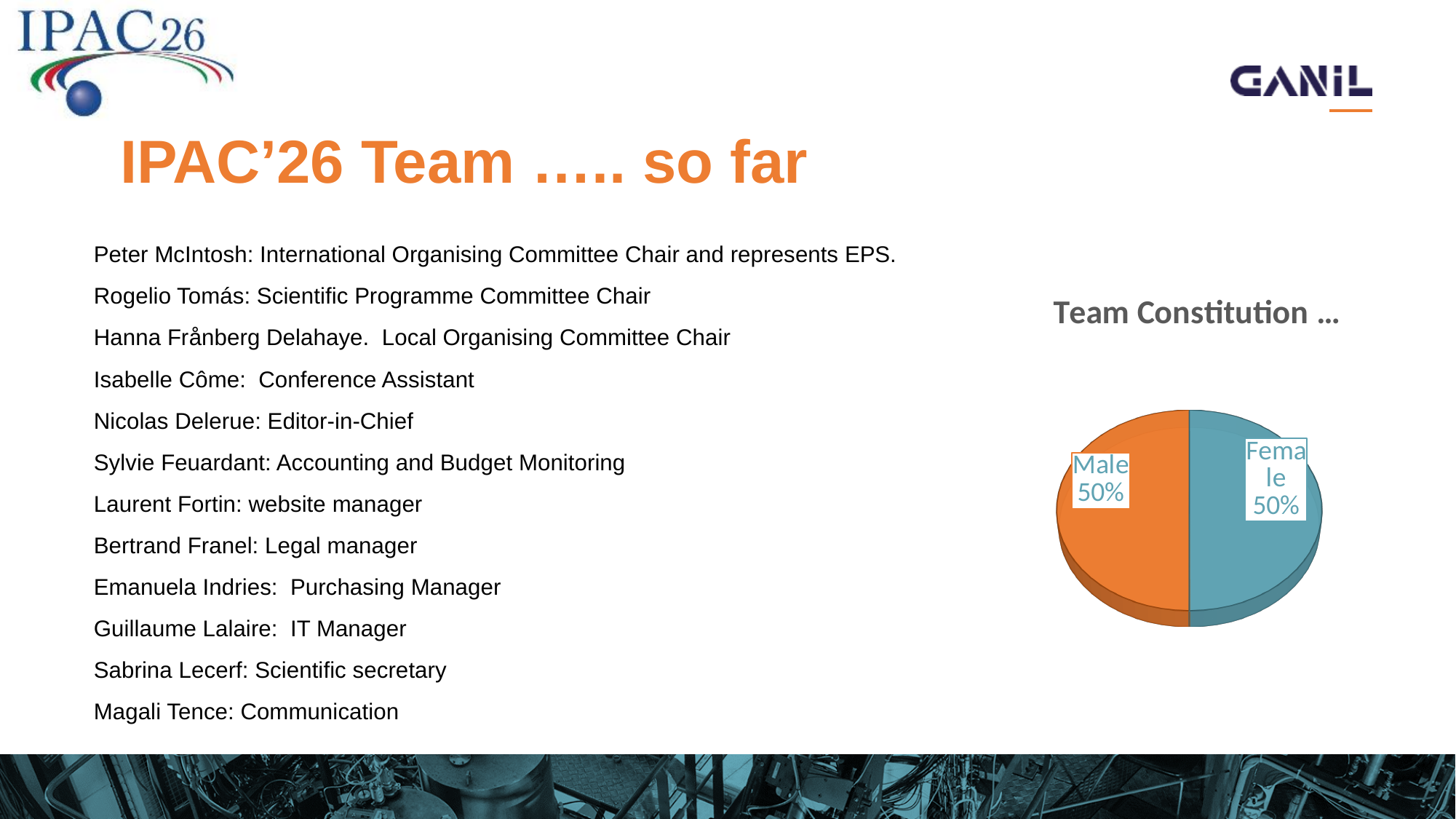
What kind of chart is shown on the slide? pie chart What is the title of the chart? Team Constitution … What share of the pie does the Female slice represent? 50% What is the difference between the Male and Female shares? 0% What share of the pie does the Male slice represent? 50% How many slices does the pie chart have? 2 What colour is the Male slice of the pie chart? orange What is the combined share of the Male and Female slices? 100%